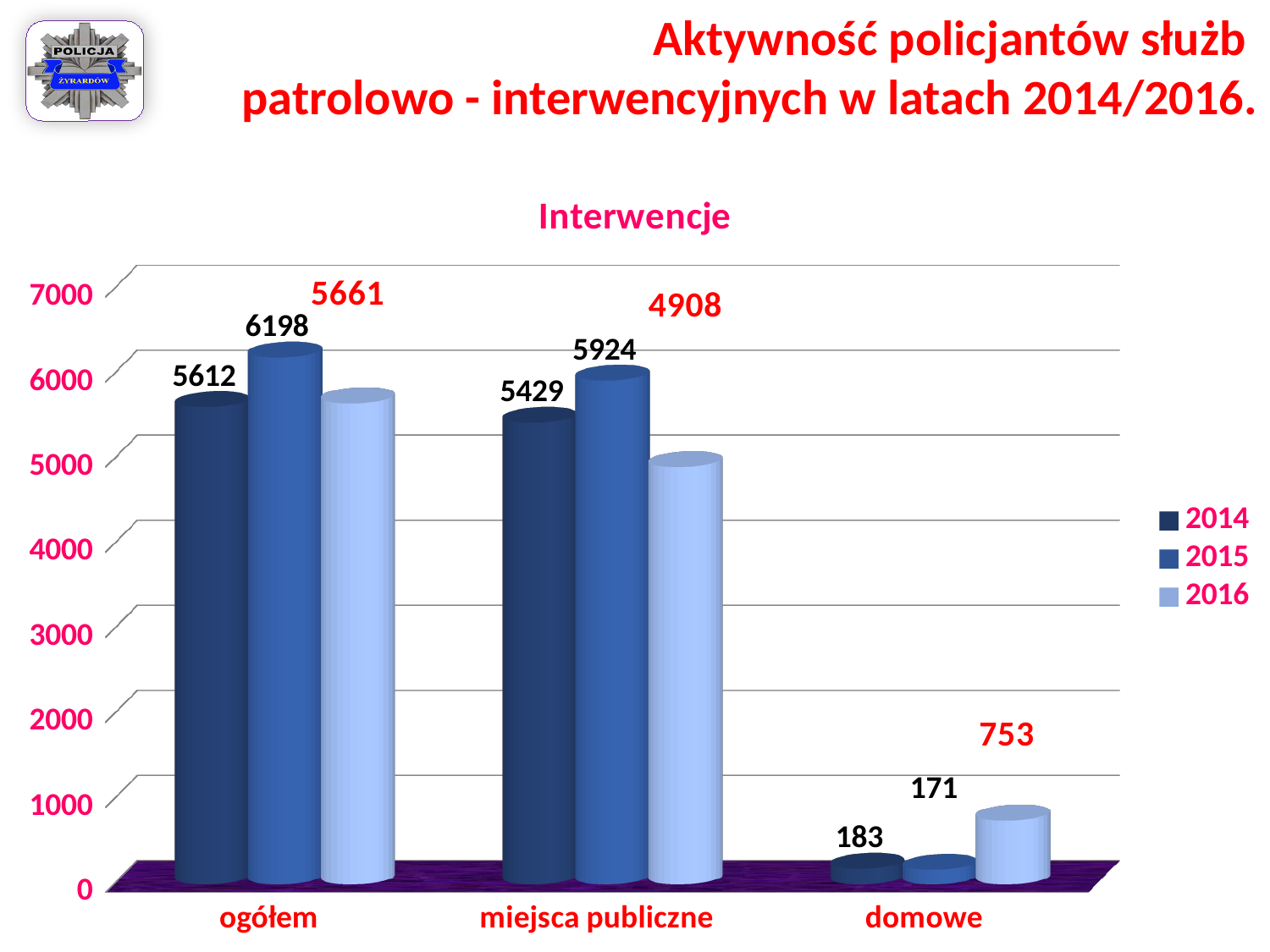
Which year has the lowest value in the 'domowe' category? 2015 What is the difference between the 2016 and 2015 values in the 'domowe' category? 582 What is the difference between the 2015 and 2014 values in the 'ogółem' category? 586 Which is larger: the 2014 value for 'miejsca publiczne' or the 2016 value for 'ogółem'? 2016 value for 'ogółem' What is the value for 2015 in the 'ogółem' category? 6198 What is the value for 2014 in the 'domowe' category? 183 How many categories are shown on the x axis? 3 How many series does the legend list? 3 What is the value for 2016 in the 'miejsca publiczne' category? 4908 What kind of chart is shown on the slide? bar chart Which year has the highest value in the 'ogółem' category? 2015 What is the title of the chart? Interwencje